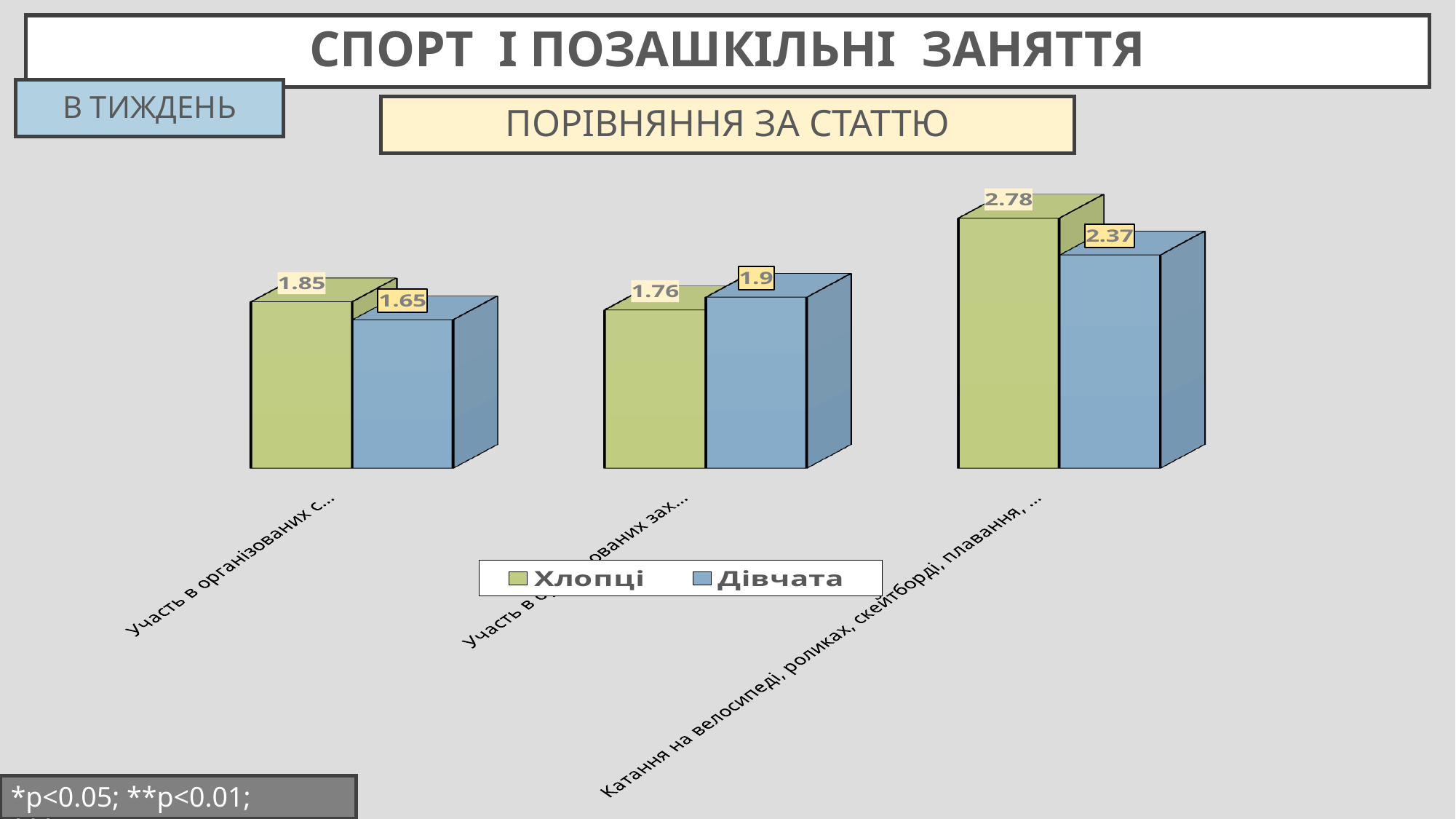
Which category has the highest value for Хлопці? Катання на велосипеді, роликах, скейтборді, плавання, ... What is the value for Дівчата in the second (middle) category? 1.9 What is the difference between the Хлопці and Дівчата values in the category 'Катання на велосипеді, роликах, скейтборді, плавання, ...'? 0.41 What is the value for Хлопці in the category 'Катання на велосипеді, роликах, скейтборді, плавання, ...'? 2.78 Which category has the lowest value for Дівчата? Участь в організованих с... (the first category) How many categories are plotted in the chart? 3 How many series does the legend list? 2 What is the value for Дівчата in the first category ('Участь в організованих с...')? 1.65 What kind of chart is shown on the slide? bar chart In the second (middle) category, which series has the larger value, Хлопці or Дівчата? Дівчата What is the value for Дівчата in the category 'Катання на велосипеді, роликах, скейтборді, плавання, ...'? 2.37 What is the value for Хлопці in the first category ('Участь в організованих с...')? 1.85